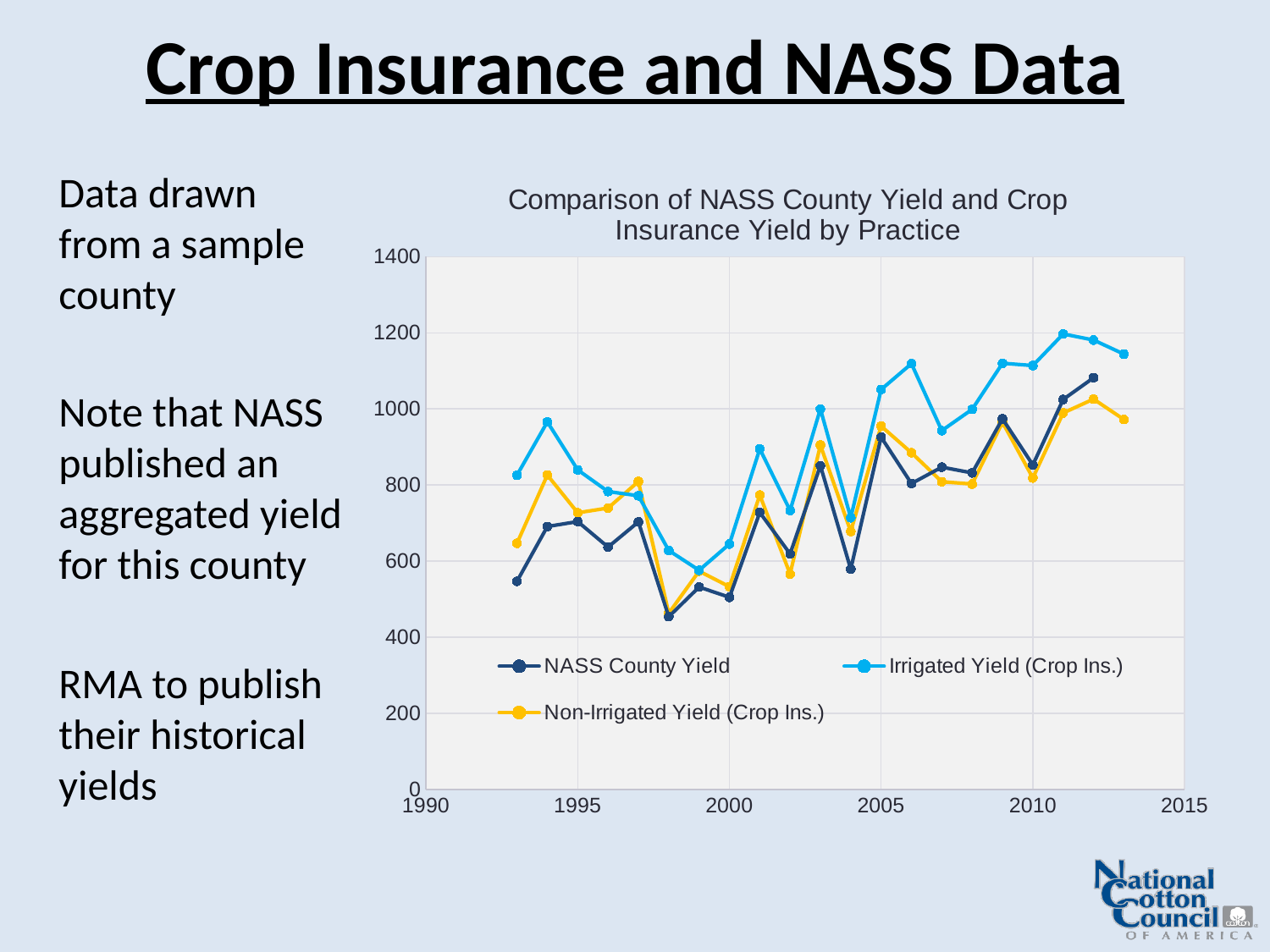
Is the NASS County Yield value for 1998 greater or less than 600? less Is the Irrigated Yield (Crop Ins.) value for 1999 greater or less than 800? less In 2011, which is larger: the Irrigated Yield (Crop Ins.) or the NASS County Yield? Irrigated Yield (Crop Ins.) Is the Irrigated Yield (Crop Ins.) value for 2011 greater or less than 1000? greater In which year is the NASS County Yield at its lowest? 1998 Overall, does the Irrigated Yield (Crop Ins.) rise or fall from 1993 to 2013? rise What is the title of the chart? Comparison of NASS County Yield and Crop Insurance Yield by Practice What kind of chart is shown on the slide? line chart How many series does the chart's legend list? 3 Which series is drawn in yellow? Non-Irrigated Yield (Crop Ins.)